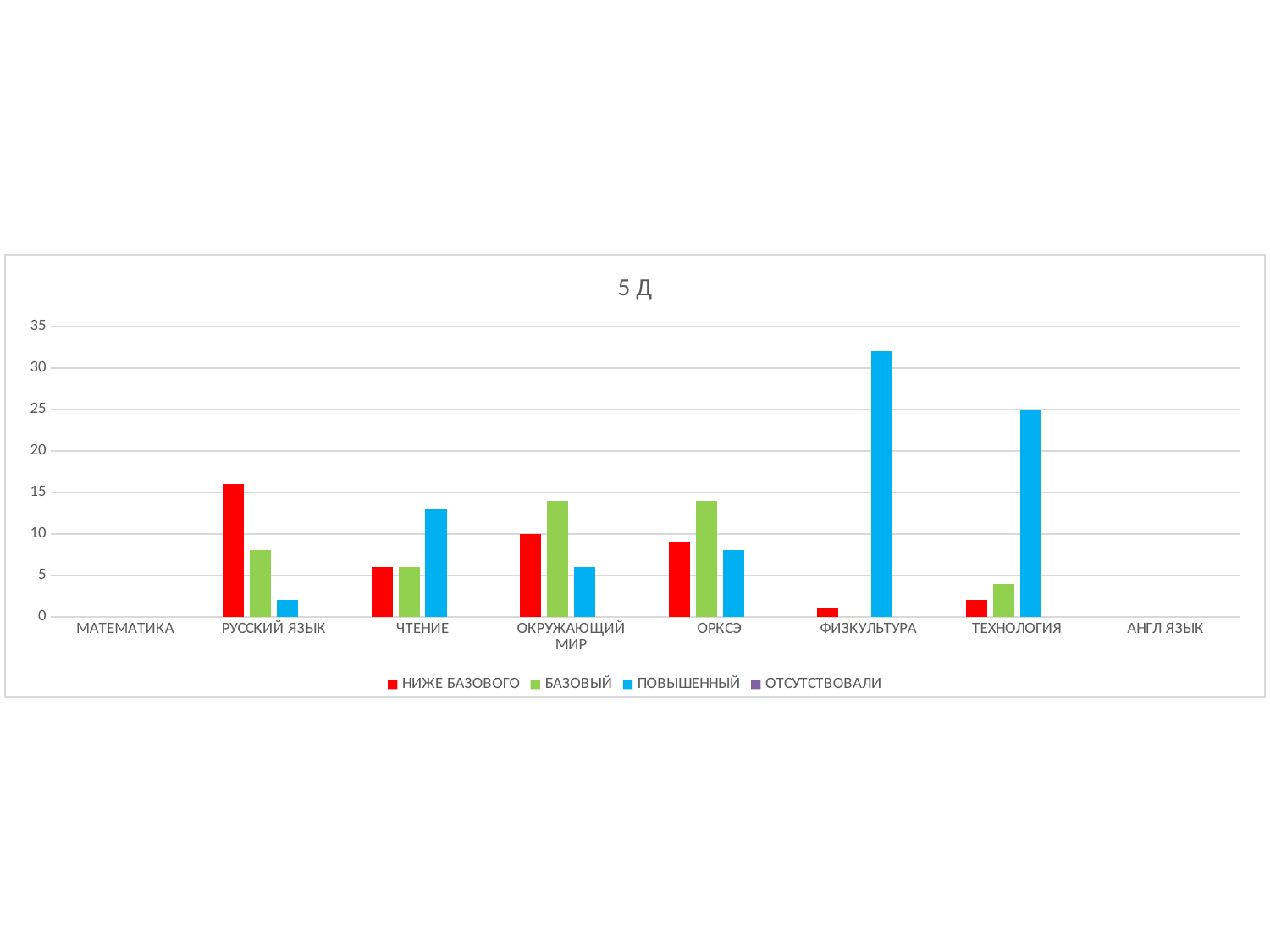
Is the ПОВЫШЕННЫЙ value for РУССКИЙ ЯЗЫК greater or less than 5? less What is the НИЖЕ БАЗОВОГО value for ОКРУЖАЮЩИЙ МИР? 10 For РУССКИЙ ЯЗЫК, which is larger: НИЖЕ БАЗОВОГО or БАЗОВЫЙ? НИЖЕ БАЗОВОГО What is the title of the chart? 5 Д How many subject categories are shown on the x axis? 8 Is the НИЖЕ БАЗОВОГО value for РУССКИЙ ЯЗЫК greater or less than 15? greater Is the ПОВЫШЕННЫЙ value for ФИЗКУЛЬТУРА greater or less than 30? greater How many series does the legend list? 4 What kind of chart is shown on the slide? bar chart Which subject has the highest ПОВЫШЕННЫЙ value? ФИЗКУЛЬТУРА Which colour represents the ПОВЫШЕННЫЙ series? blue What is the ПОВЫШЕННЫЙ value for ТЕХНОЛОГИЯ? 25